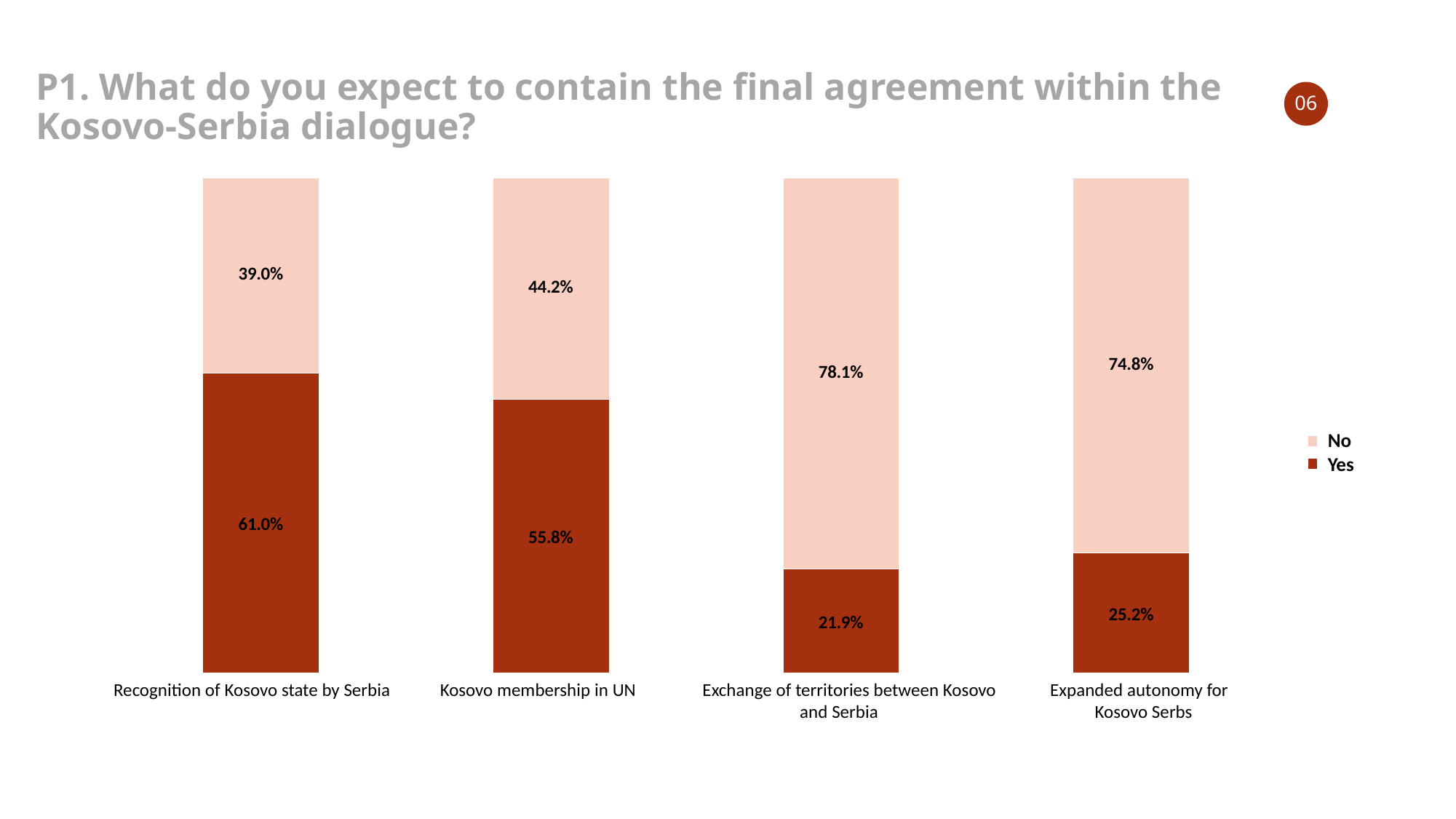
What is the total of the stacked bar for Kosovo membership in UN? 100.0% What kind of chart is shown on the slide? Stacked bar chart What percentage of respondents answered Yes for Recognition of Kosovo state by Serbia? 61.0% Which is larger: the Yes value for Kosovo membership in UN or the Yes value for Expanded autonomy for Kosovo Serbs? Kosovo membership in UN What is the No value for Kosovo membership in UN? 44.2% What is the No value for Expanded autonomy for Kosovo Serbs? 74.8% Which category has the highest Yes value? Recognition of Kosovo state by Serbia How many series does the legend list? 2 Which category has the lowest Yes value? Exchange of territories between Kosovo and Serbia How many categories are shown on the x axis? 4 What is the difference between the No and Yes values for Exchange of territories between Kosovo and Serbia? 56.2% What is the Yes value for Exchange of territories between Kosovo and Serbia? 21.9%